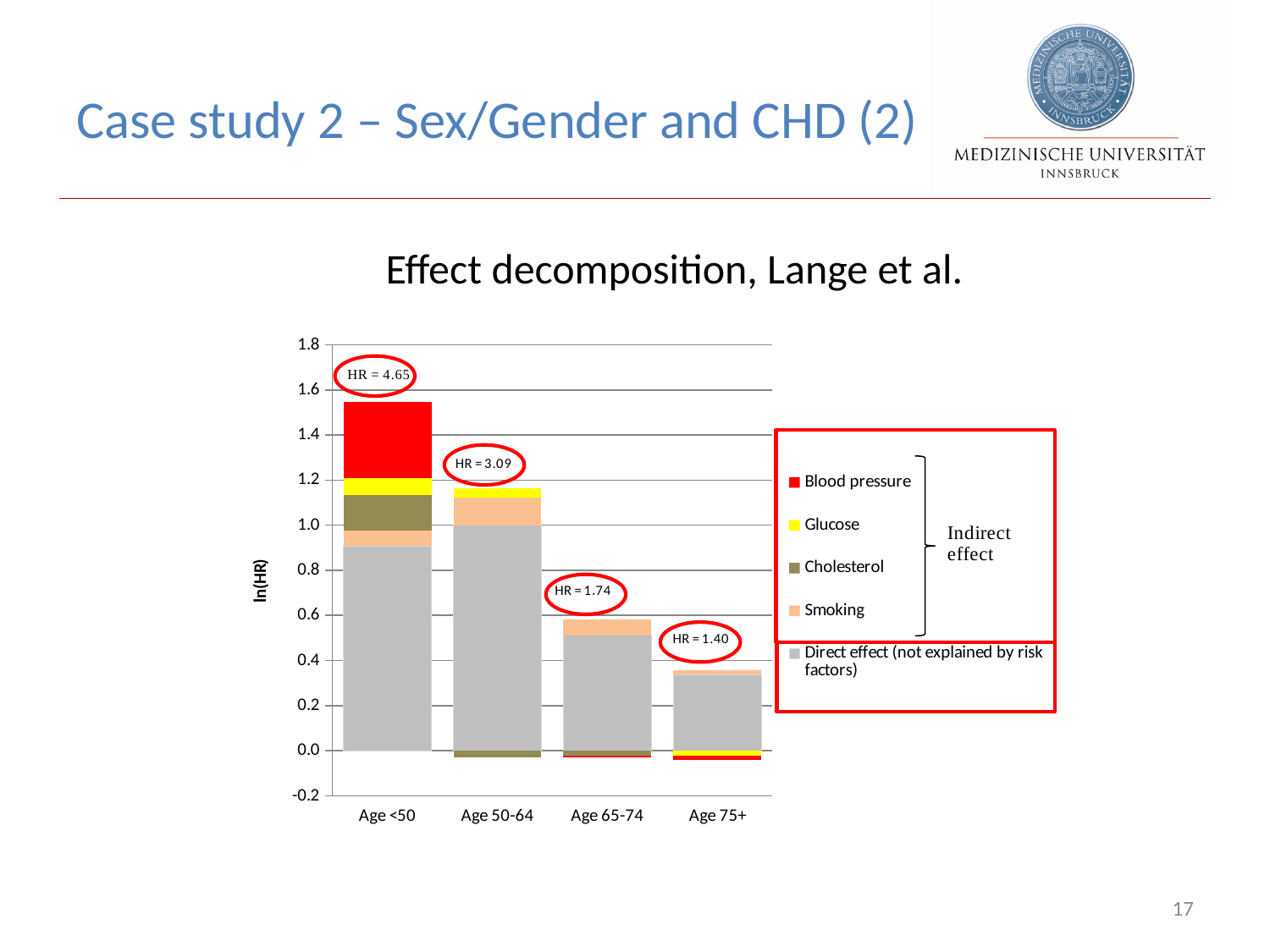
Which age group has the shortest stacked bar? Age 75+ Do the stacked bar heights rise or fall as age increases along the x axis? Fall Is the annotated HR for Age 50-64 larger or smaller than the annotated HR for Age 65-74? Larger What kind of chart is shown on the slide? Stacked bar chart How many series does the chart's legend list? 5 What is the label on the vertical axis of the chart? ln(HR) Which age group has the tallest stacked bar? Age <50 What is the difference between the annotated HR for Age <50 and the annotated HR for Age 75+? 3.25 What HR value is annotated above the bar for Age 75+? HR = 1.40 Is the top of the stacked bar for Age 65-74 greater or less than 0.8 on the ln(HR) axis? less How many age categories are shown on the x axis of the chart? 4 What HR value is annotated above the bar for Age <50? HR = 4.65